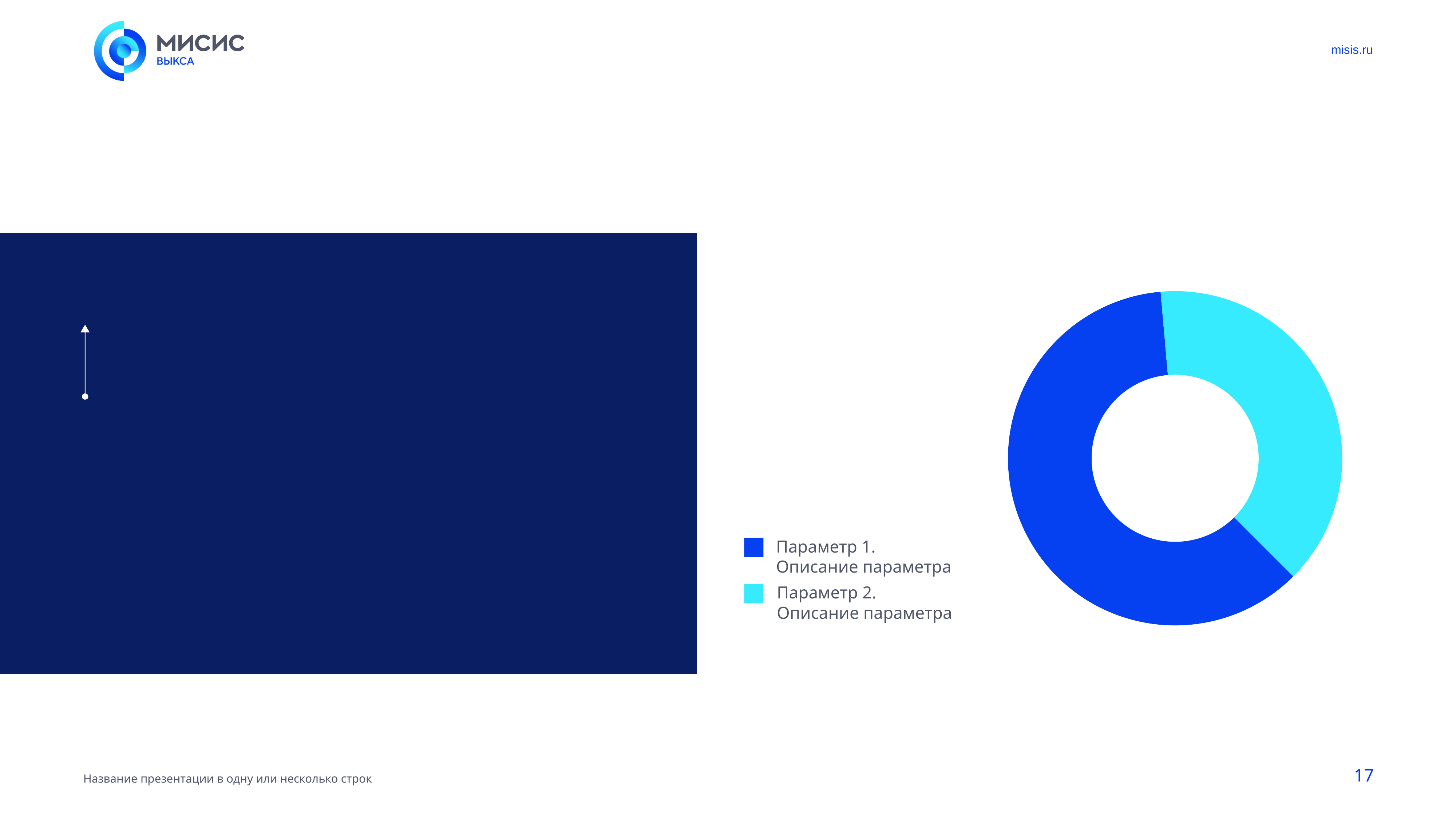
Which category has the smallest slice in the donut chart? Параметр 2 What is the first legend entry of the donut chart? Параметр 1. Описание параметра Which category has the largest slice in the donut chart? Параметр 1 How many entries does the legend of the donut chart list? 2 How many slices does the donut chart have? 2 What kind of chart is shown on the slide? Pie chart (donut) Which slice is larger, Параметр 1 or Параметр 2? Параметр 1 What colour is the slice for Параметр 2 in the donut chart? Light blue (cyan)